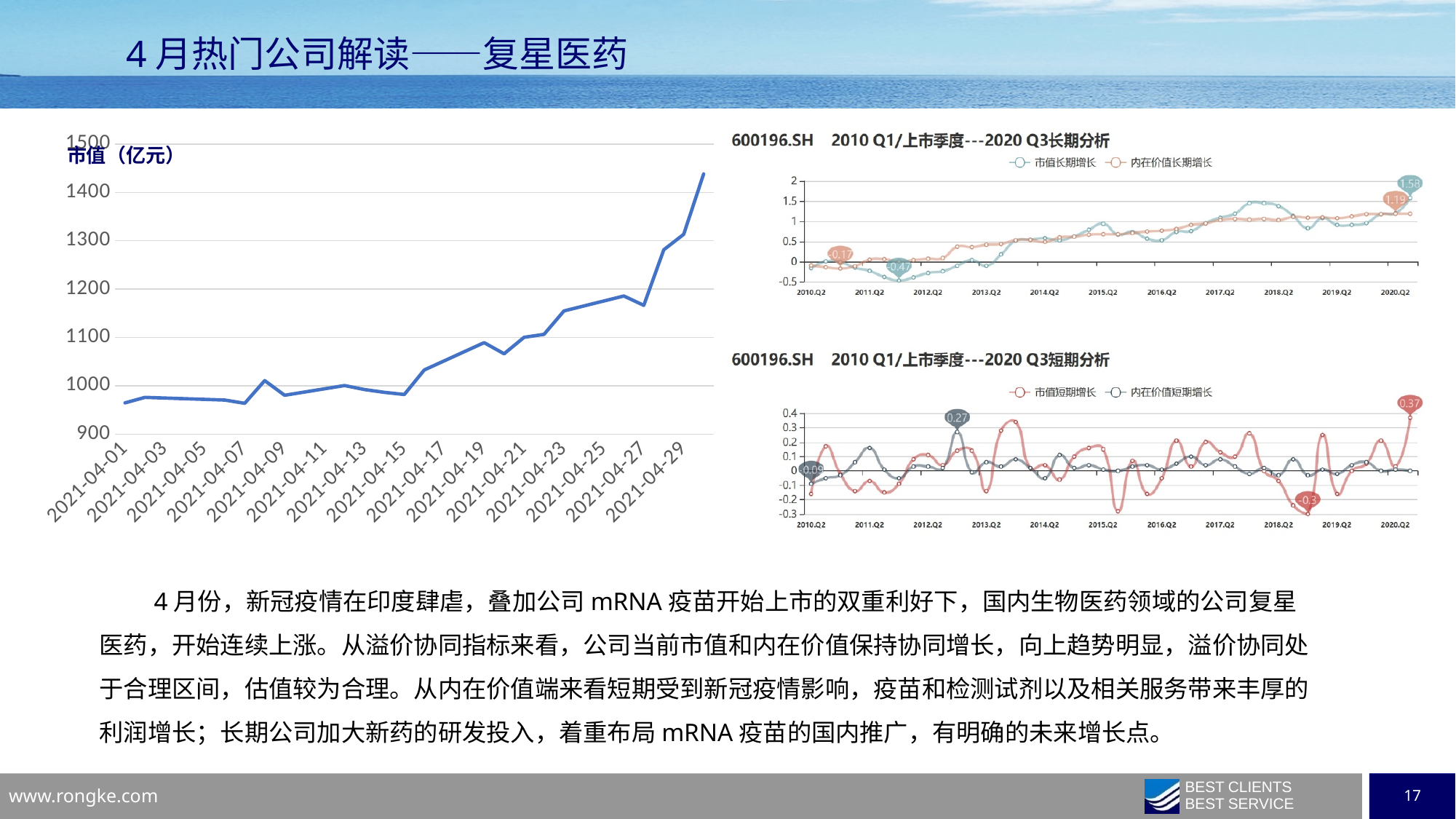
What kind of chart is the left chart titled 市值（亿元）? line chart In the bottom-right chart (短期分析), what is the labelled final value of 市值短期增长? 0.37 In the top-right chart (长期分析), what is the labelled final value of 内在价值长期增长? 1.19 How many series does the legend list in the top-right chart (长期分析)? 2 In the left chart titled 市值（亿元）, do the values generally rise or fall from 2021-04-01 to the end of the month? rise In the left chart titled 市值（亿元）, is the final plotted value greater or less than 1400? greater In the left chart titled 市值（亿元）, is the value for 2021-04-01 greater or less than 1000? less In the left chart titled 市值（亿元）, is the value for 2021-04-27 greater or less than 1100? greater In the top-right chart (长期分析), what is the difference between the labelled final values 1.58 and 1.19? 0.39 In the top-right chart (长期分析), what is the labelled final value of 市值长期增长? 1.58 In the bottom-right chart (短期分析), what is the lowest labelled value shown? -0.3 How many date labels are shown on the x axis of the left chart titled 市值（亿元）? 15